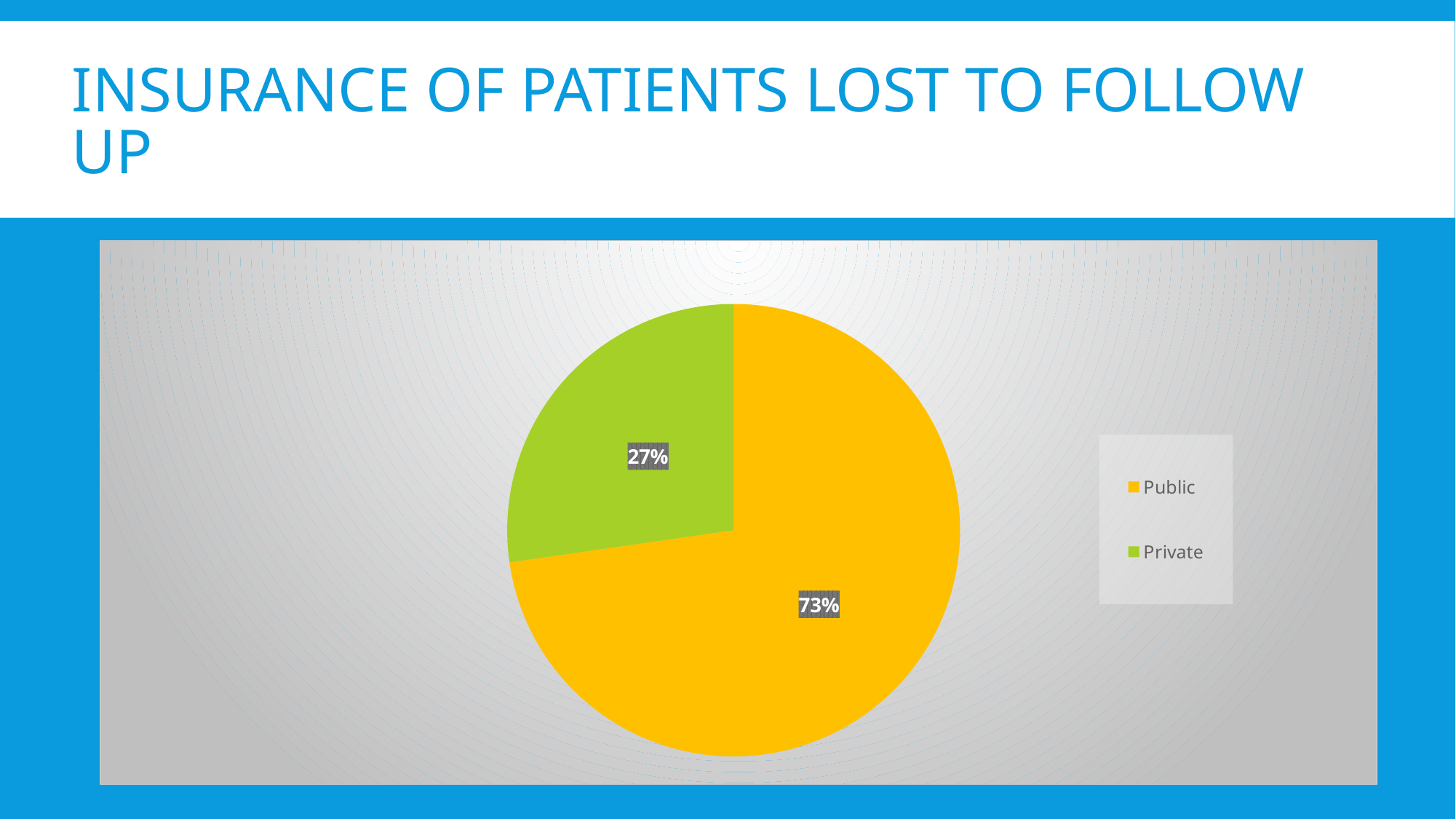
Which insurance category has the smallest share of the pie? Private What share of the pie does the Private slice represent? 27% Which slice is larger, Public or Private? Public How many entries does the legend list? 2 What colour is the Private slice? green What is the difference in percentage points between the Public and Private slices? 46 Which insurance category has the largest share of the pie? Public How many slices does the pie chart have? 2 What kind of chart is shown on the slide? pie chart What percentage of patients lost to follow up had Public insurance? 73% What colour is the Public slice? yellow What percentage of patients lost to follow up had Private insurance? 27%